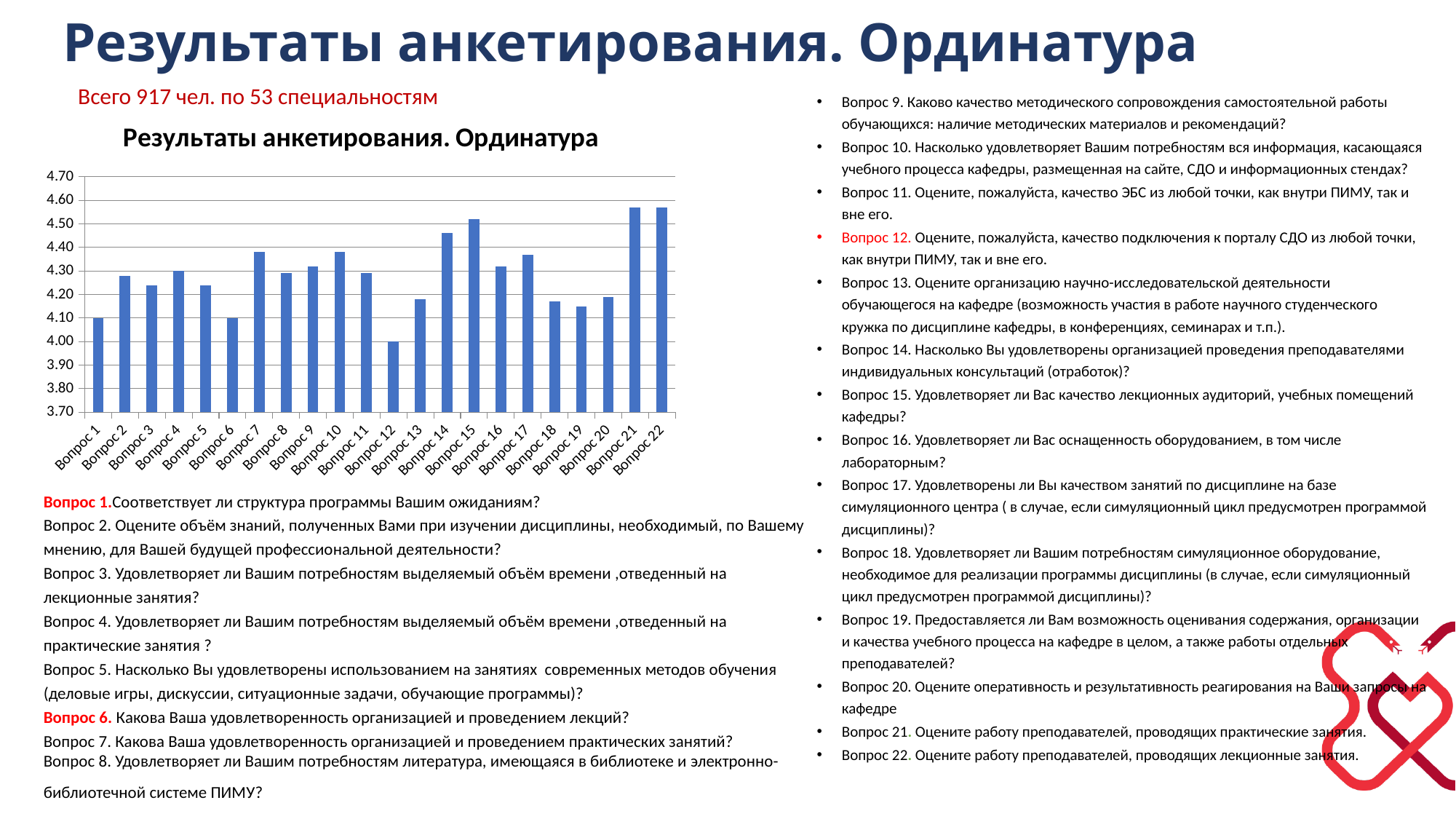
How many categories (questions) are plotted on the x axis of the chart? 22 Which is larger, the value for Вопрос 13 or the value for Вопрос 14? Вопрос 14 Which is larger, the value for Вопрос 15 or the value for Вопрос 16? Вопрос 15 Is the value for Вопрос 7 greater or less than 4.30? greater Is the value for Вопрос 19 greater or less than 4.20? less What is the title of the chart? Результаты анкетирования. Ординатура What kind of chart is shown on the slide? bar chart Which category has the lowest value in the chart? Вопрос 12 Which is larger, the value for Вопрос 10 or the value for Вопрос 12? Вопрос 10 Is the value for Вопрос 21 greater or less than 4.50? greater What is the value for Вопрос 12? 4.00